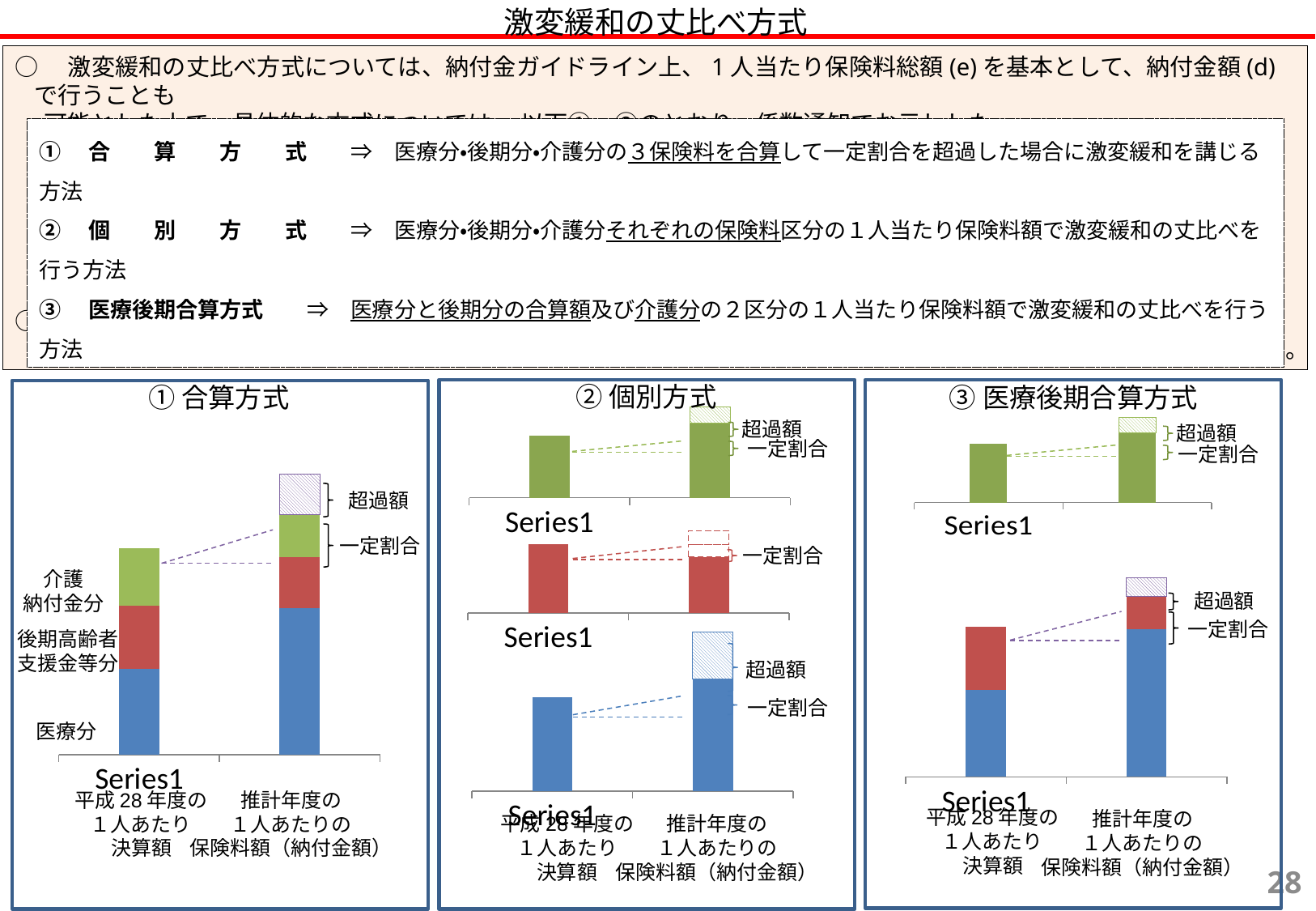
In the bottom (blue) chart of the ② 個別方式 panel, which bar is taller: 平成28年度 or 推計年度? 推計年度 In the ① 合算方式 chart, which segment is at the bottom of each stacked bar? 医療分 In the ① 合算方式 chart, what colour is the 介護納付金分 segment? green In the ① 合算方式 chart, do the bar totals rise or fall from 平成28年度 to 推計年度? rise How many separate bar charts are shown in the ② 個別方式 panel? 3 In the ① 合算方式 chart, which bar is taller: 平成28年度の1人あたり決算額 or 推計年度の1人あたりの保険料額（納付金額）? 推計年度の1人あたりの保険料額（納付金額） In the lower chart of the ③ 医療後期合算方式 panel, do the bar totals rise or fall from 平成28年度 to 推計年度? rise In the ② 個別方式 panel, which of the three charts has no 超過額 (hatched excess) area on the 推計年度 bar? the middle (red) chart In the ① 合算方式 chart, how many categories are shown on the x axis? 2 In the lower chart of the ③ 医療後期合算方式 panel, how many stacked segments make up each bar? 2 for the 平成28年度 bar (blue and red); 3 for the 推計年度 bar, which adds a hatched 超過額 segment on top What kind of chart is shown in the ① 合算方式 panel? stacked bar chart